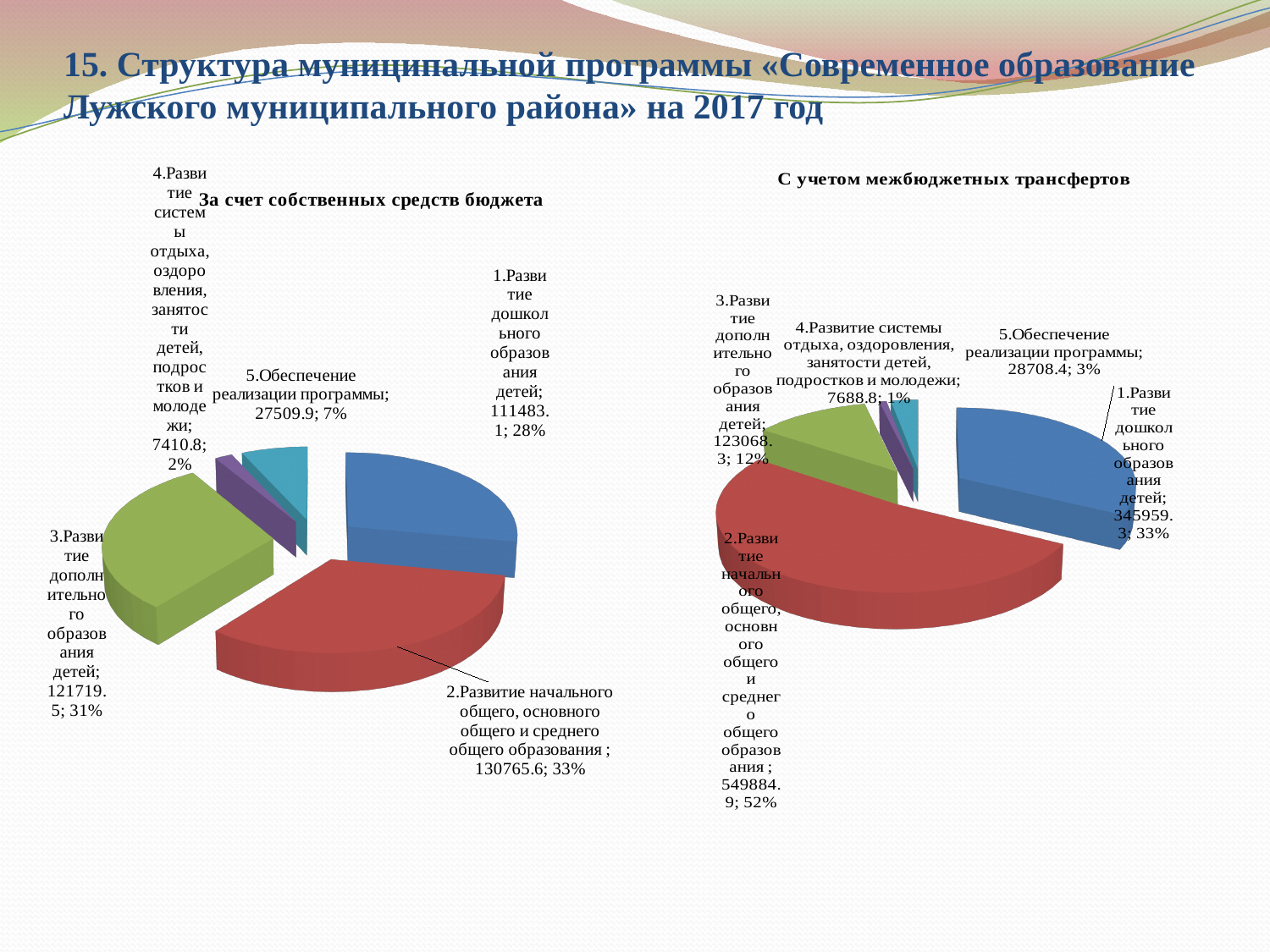
In the chart titled «С учетом межбюджетных трансфертов», what is the difference between the values for «1.Развитие дошкольного образования детей» and «5.Обеспечение реализации программы»? 317250.9 In the chart titled «За счет собственных средств бюджета», what percentage share is shown for «1.Развитие дошкольного образования детей»? 28% In the chart titled «С учетом межбюджетных трансфертов», which is larger: the value for «5.Обеспечение реализации программы» or for «4.Развитие системы отдыха, оздоровления, занятости детей, подростков и молодежи»? 5.Обеспечение реализации программы In the chart titled «За счет собственных средств бюджета», which category has the smallest value? 4.Развитие системы отдыха, оздоровления, занятости детей, подростков и молодежи What is the title of the chart on the right side of the slide? С учетом межбюджетных трансфертов In the chart titled «За счет собственных средств бюджета», what value is shown for «2.Развитие начального общего, основного общего и среднего общего образования»? 130765.6 What type of chart is used on the left side of the slide, titled «За счет собственных средств бюджета»? Pie chart In the chart titled «С учетом межбюджетных трансфертов», what percentage share is shown for «3.Развитие дополнительного образования детей»? 12% In the chart titled «За счет собственных средств бюджета», what is the difference between the values for «3.Развитие дополнительного образования детей» and «5.Обеспечение реализации программы»? 94209.6 In the chart titled «С учетом межбюджетных трансфертов», what value is shown for «2.Развитие начального общего, основного общего и среднего общего образования»? 549884.9 In the chart titled «С учетом межбюджетных трансфертов», which category has the largest value? 2.Развитие начального общего, основного общего и среднего общего образования In the chart titled «За счет собственных средств бюджета», how many slices does the pie have? 5